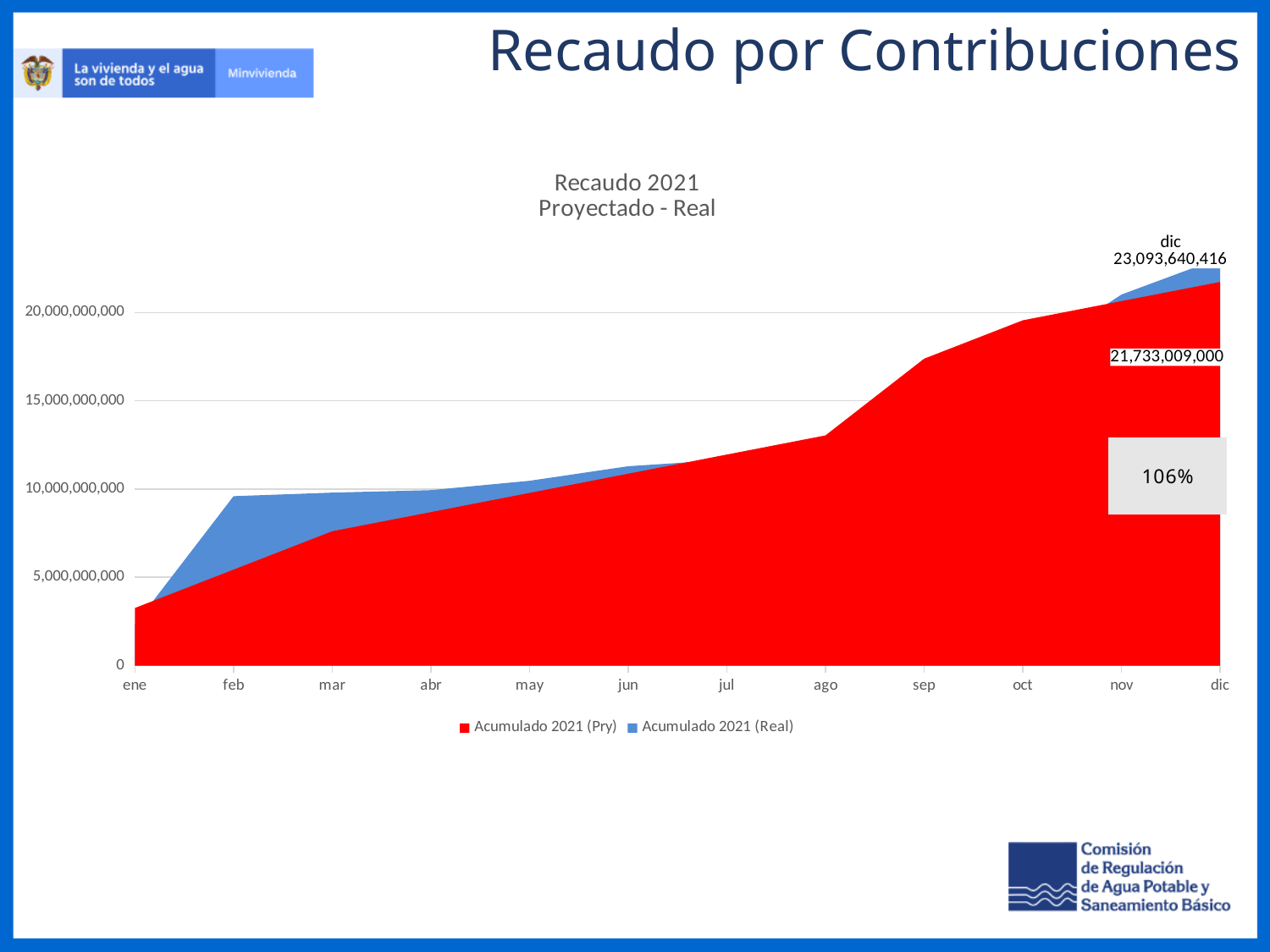
How many series does the legend list? 2 What is the title of the chart? Recaudo 2021 Proyectado - Real Is the value of Acumulado 2021 (Pry) in ene greater or less than 5,000,000,000? less What is the value of Acumulado 2021 (Pry) in dic? 21,733,009,000 What type of chart is shown on the slide? Area chart In dic, which is larger: Acumulado 2021 (Real) or Acumulado 2021 (Pry)? Acumulado 2021 (Real) What is the difference between Acumulado 2021 (Real) and Acumulado 2021 (Pry) in dic? 1,360,631,416 Do the Acumulado 2021 (Pry) values rise or fall from ene to dic? rise Which colour represents Acumulado 2021 (Real) in the chart? Blue What is the value of Acumulado 2021 (Real) in dic? 23,093,640,416 How many months are shown along the x axis? 12 Is the value of Acumulado 2021 (Pry) in ago greater or less than 10,000,000,000? greater